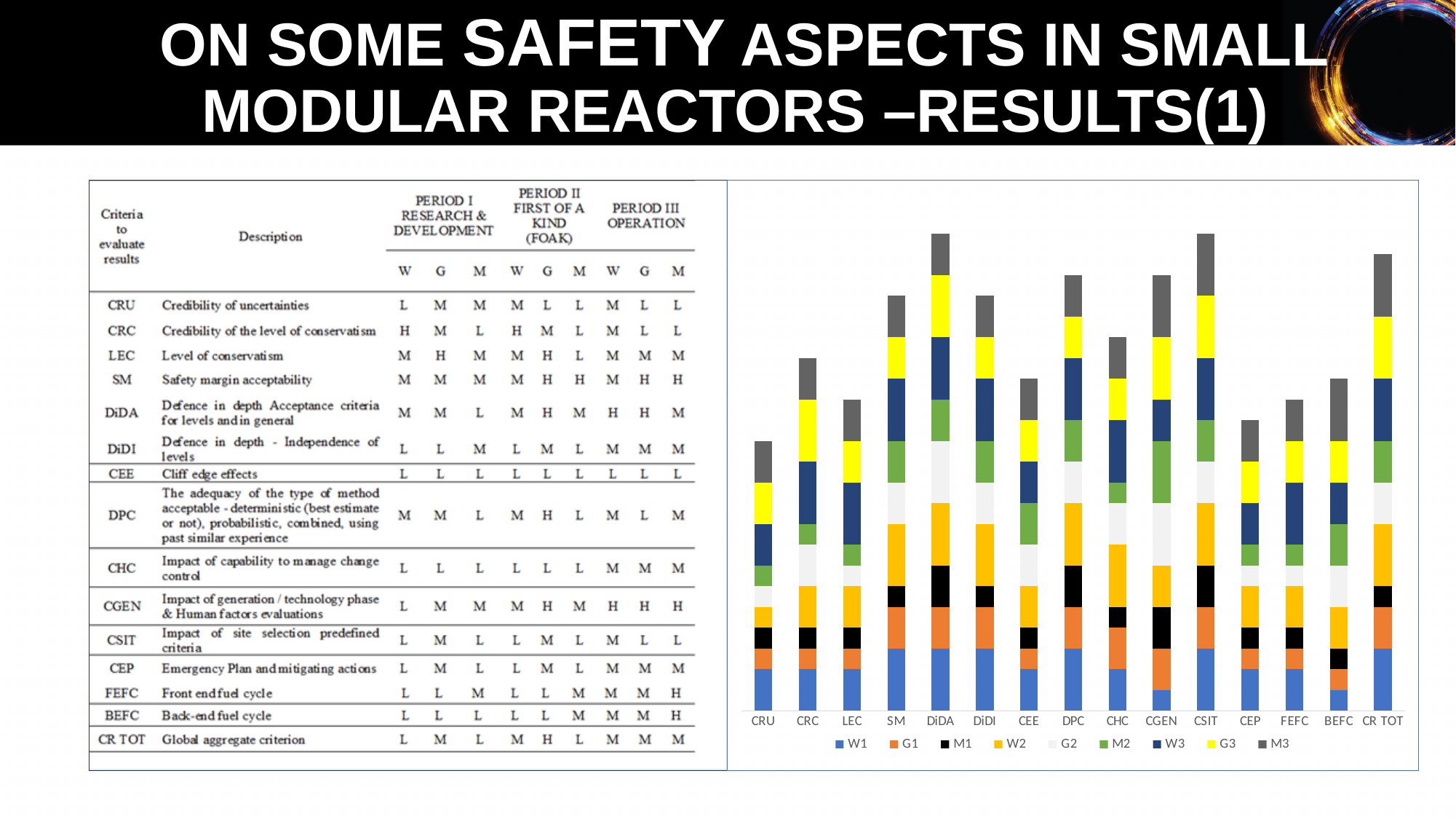
What kind of chart is shown on the right side of the slide? Stacked bar chart How many series does the legend of the bar chart list? 9 Which stacked bar is taller, CEP or CSIT? CSIT What is the first series listed in the chart legend? W1 Which stacked bar is taller, CHC or DiDA? DiDA Which stacked bar is taller, LEC or DPC? DPC How many categories are shown along the x axis of the bar chart? 15 Which category has the shortest stacked bar in the chart? CRU What is the last series listed in the chart legend? M3 What is the label of the last category on the x axis of the bar chart? CR TOT